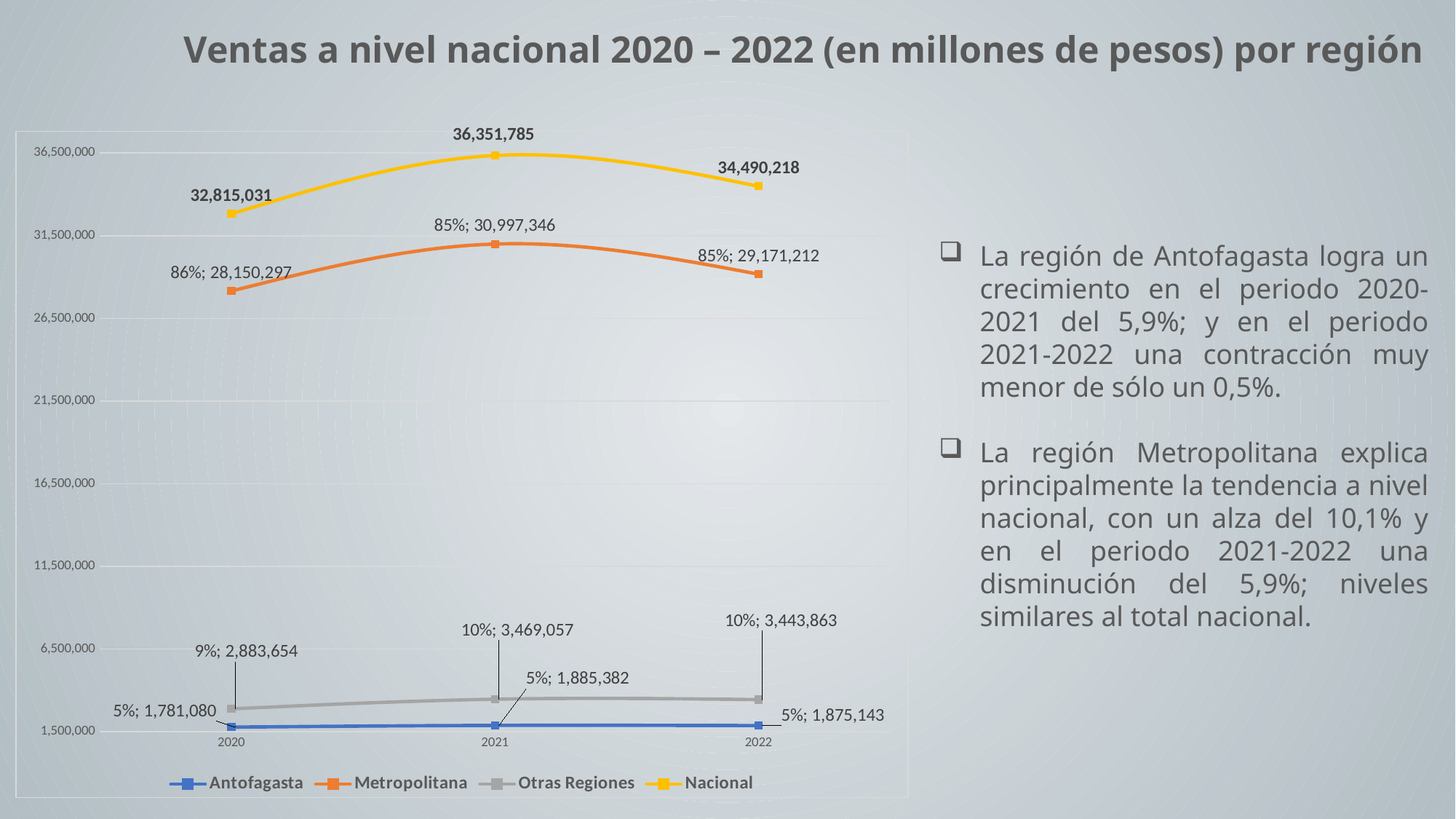
In which year is the Nacional series highest? 2021 Which is larger: the Otras Regiones value for 2022 or the Antofagasta value for 2022? Otras Regiones What is the Nacional value for 2021? 36,351,785 What is the Metropolitana value for 2020? 28,150,297 What is the difference between the Nacional values for 2021 and 2020? 3,536,754 What is the Antofagasta value for 2022? 1,875,143 What percentage share is shown next to the Metropolitana value for 2020? 86% How many series does the legend list? 4 What is the Otras Regiones value for 2021? 3,469,057 How many years are plotted on the x axis? 3 In which year is the Metropolitana series lowest? 2020 What type of chart is shown on the slide? Line chart